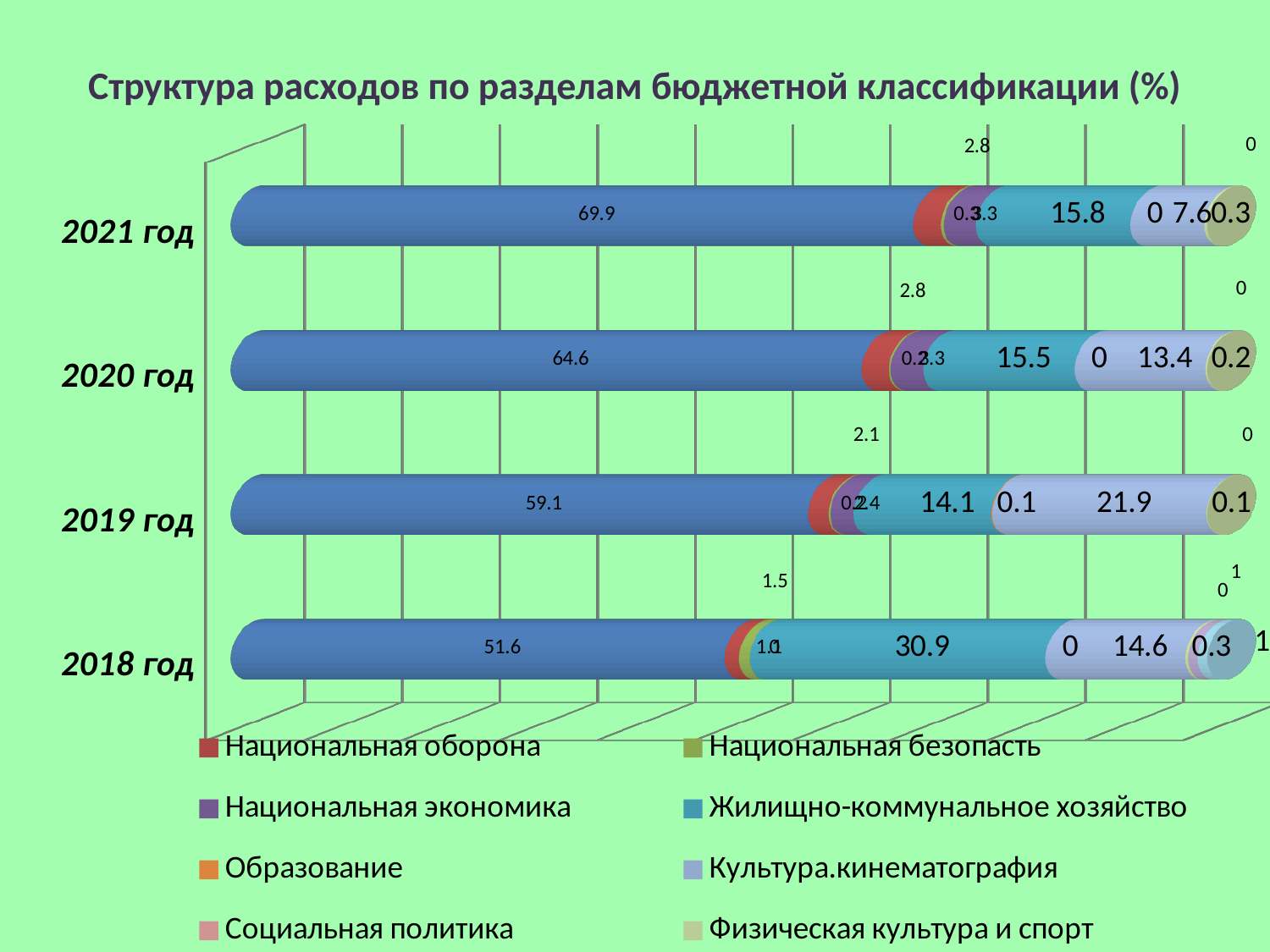
How many years (bars) are shown in the chart? 4 Which year has the larger value for Культура.кинематография, 2020 год or 2021 год? 2020 год What value is printed on the largest segment of the 2021 год bar? 69.9 How many series does the legend list? 8 What is the value for Жилищно-коммунальное хозяйство in 2018 год? 30.9 What is the title of the chart? Структура расходов по разделам бюджетной классификации (%) What kind of chart is shown on the slide? Stacked bar chart What is the value for Культура.кинематография in 2019 год? 21.9 What is the value for Национальная оборона in 2019 год? 2.1 In which year is the value for Культура.кинематография the highest? 2019 год What is the difference between the Жилищно-коммунальное хозяйство values for 2021 год and 2020 год? 0.3 In which year is the value for Жилищно-коммунальное хозяйство the highest? 2018 год